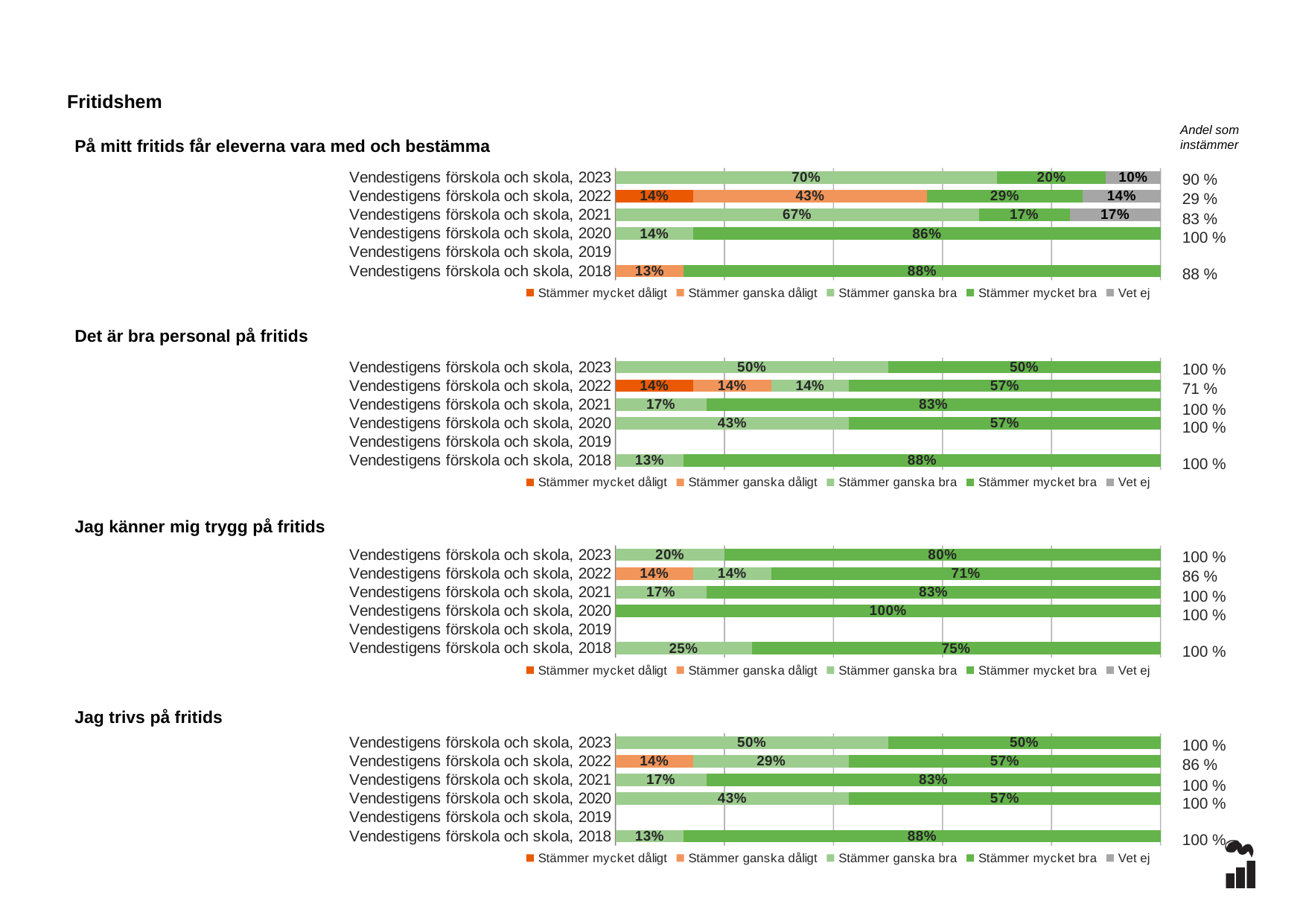
In the chart 'På mitt fritids får eleverna vara med och bestämma', what is the 'Stämmer mycket dåligt' value for Vendestigens förskola och skola, 2022? 14% In the chart 'Det är bra personal på fritids', which year has the lowest 'Andel som instämmer'? Vendestigens förskola och skola, 2022 In the chart 'På mitt fritids får eleverna vara med och bestämma', what is the 'Andel som instämmer' for Vendestigens förskola och skola, 2022? 29 % In the chart 'På mitt fritids får eleverna vara med och bestämma', what is the 'Andel som instämmer' for Vendestigens förskola och skola, 2021? 83 % In the chart 'Jag trivs på fritids', what is the 'Stämmer ganska bra' value for Vendestigens förskola och skola, 2022? 29% In the chart 'Jag känner mig trygg på fritids', what is the difference between the 'Stämmer mycket bra' values for 2023 and 2018? 5% How many series does the legend list in the chart 'Jag trivs på fritids'? 5 In the chart 'Jag trivs på fritids', which is larger: the 'Stämmer mycket bra' value for 2021 or for 2020? 2021 What kind of chart is 'Det är bra personal på fritids'? Stacked bar chart In the chart 'Det är bra personal på fritids', what is the 'Stämmer mycket bra' value for Vendestigens förskola och skola, 2022? 57% In the chart 'Jag känner mig trygg på fritids', what is the 'Stämmer mycket bra' value for Vendestigens förskola och skola, 2020? 100% In the chart 'På mitt fritids får eleverna vara med och bestämma', what is the 'Stämmer ganska bra' value for Vendestigens förskola och skola, 2023? 70%